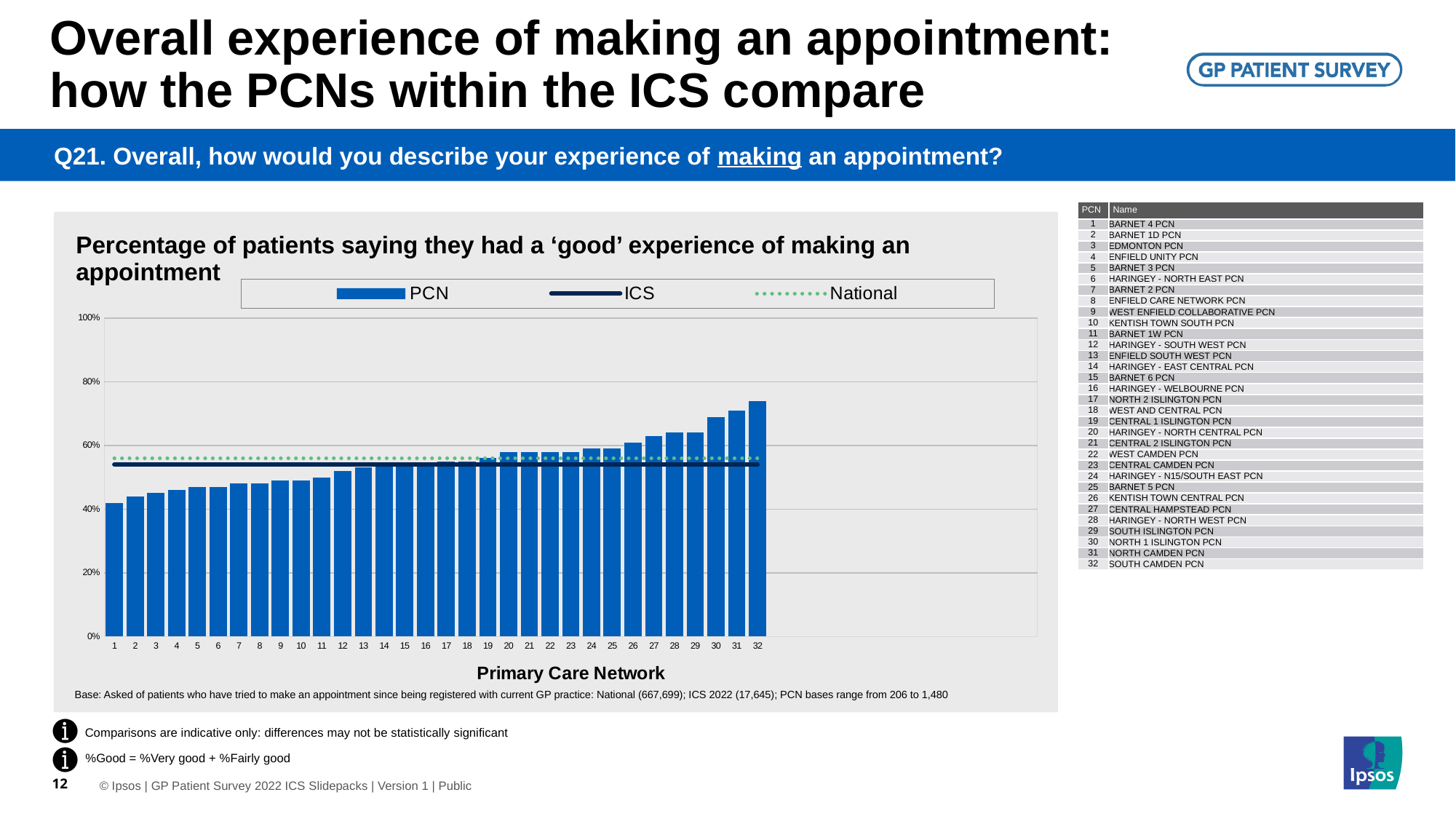
Is the value for PCN 10 greater or less than 40%? greater Is the value for PCN 30 greater or less than 60%? greater Do the bar values rise or fall moving from PCN 1 to PCN 32 along the x axis? rise What kind of chart is shown on the slide? bar chart How many Primary Care Networks (bars) are plotted on the chart? 32 What are the three entries listed in the chart legend? PCN, ICS, National Is the value for PCN 32 greater or less than 60%? greater Which PCN number has the highest percentage of patients saying they had a 'good' experience of making an appointment? 32 How many series does the chart legend list? 3 Which PCN number has the lowest percentage of patients saying they had a 'good' experience of making an appointment? 1 Which has the larger value, PCN 10 or PCN 30? PCN 30